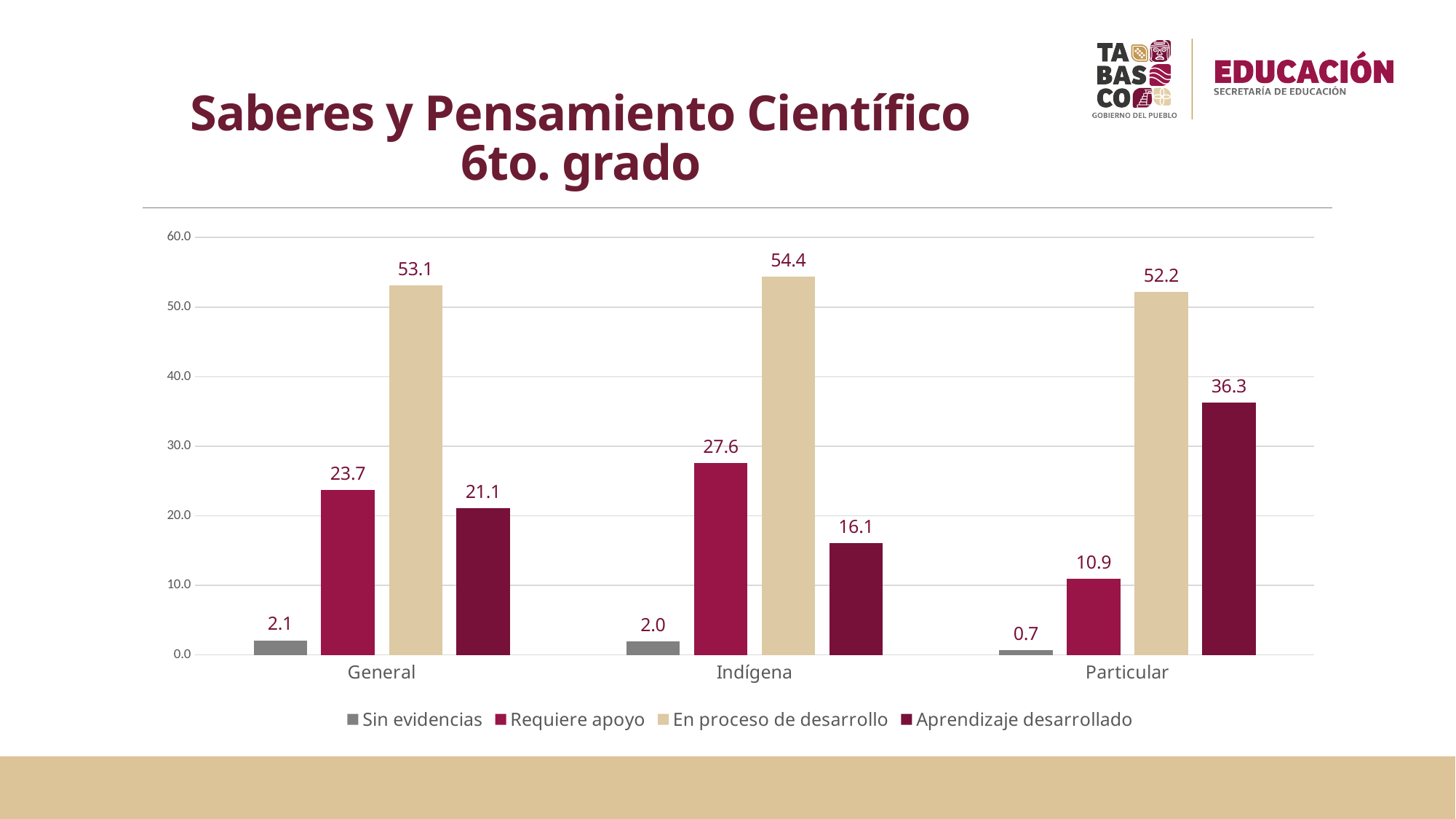
Which is larger: 'En proceso de desarrollo' for Indígena or for General? Indígena Which category has the lowest value for 'Requiere apoyo'? Particular What is the value for 'En proceso de desarrollo' in the General category? 53.1 What is the value for 'Requiere apoyo' in the Indígena category? 27.6 What is the title of the chart on the slide? Saberes y Pensamiento Científico 6to. grado Which category has the highest value for 'Sin evidencias'? General What is the difference between 'Aprendizaje desarrollado' for Particular and for Indígena? 20.2 How many series does the legend list? 4 Is the value for 'Requiere apoyo' in the General category greater or less than 20.0? greater What is the value for 'Aprendizaje desarrollado' in the Particular category? 36.3 What kind of chart is shown on the slide? bar chart How many categories are shown on the x axis? 3